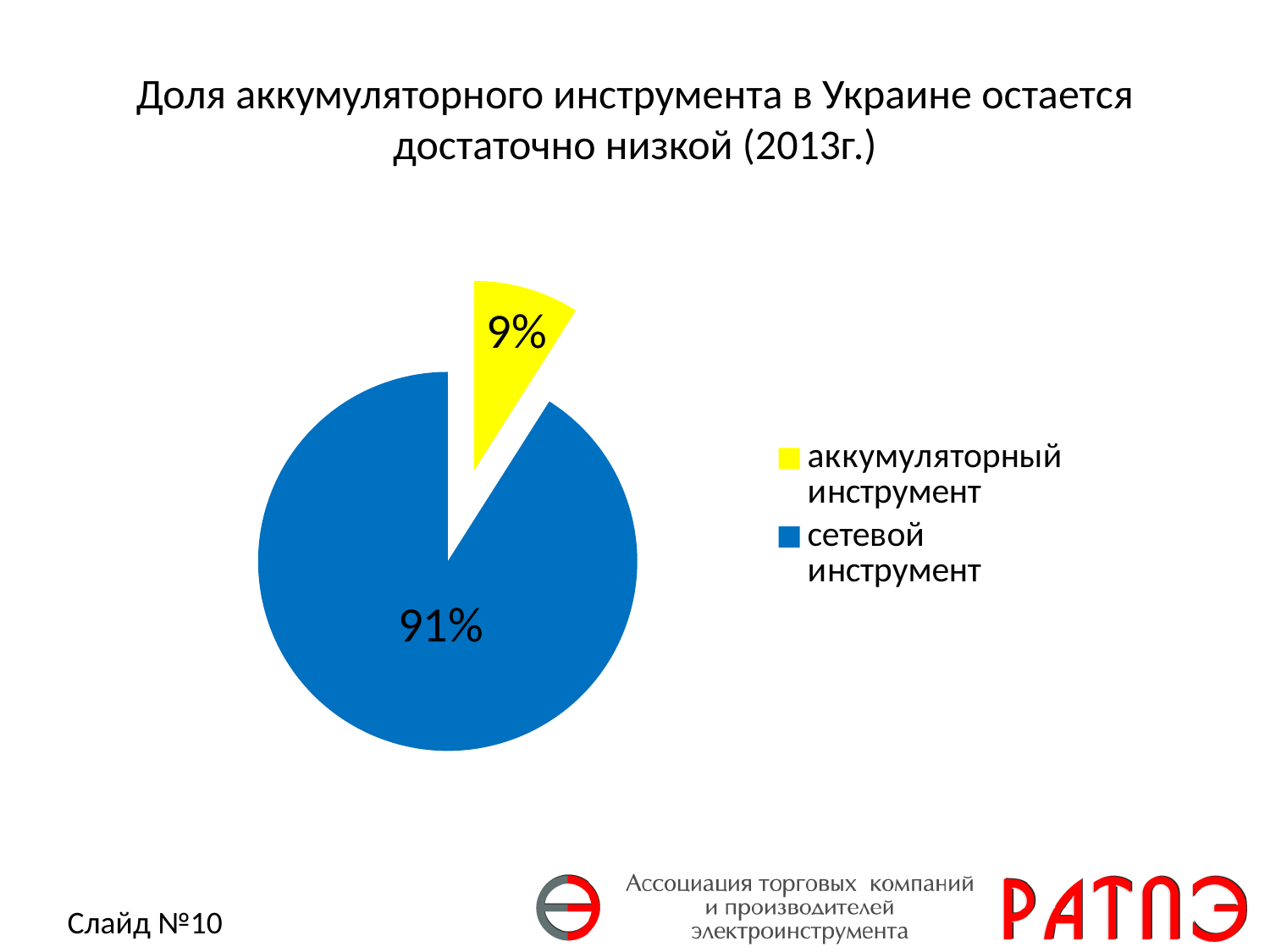
What is the difference in percentage points between сетевой инструмент and аккумуляторный инструмент? 82 Which category has the largest share of the pie? сетевой инструмент What colour is the slice for аккумуляторный инструмент? yellow How many slices does the pie chart have? 2 What share of the pie does сетевой инструмент have? 91% What kind of chart is shown on the slide? pie chart What colour is the slice for сетевой инструмент? blue How many entries does the legend list? 2 Which is larger, the share for аккумуляторный инструмент or the share for сетевой инструмент? сетевой инструмент Which category has the smallest share of the pie? аккумуляторный инструмент What share of the pie does аккумуляторный инструмент have? 9%